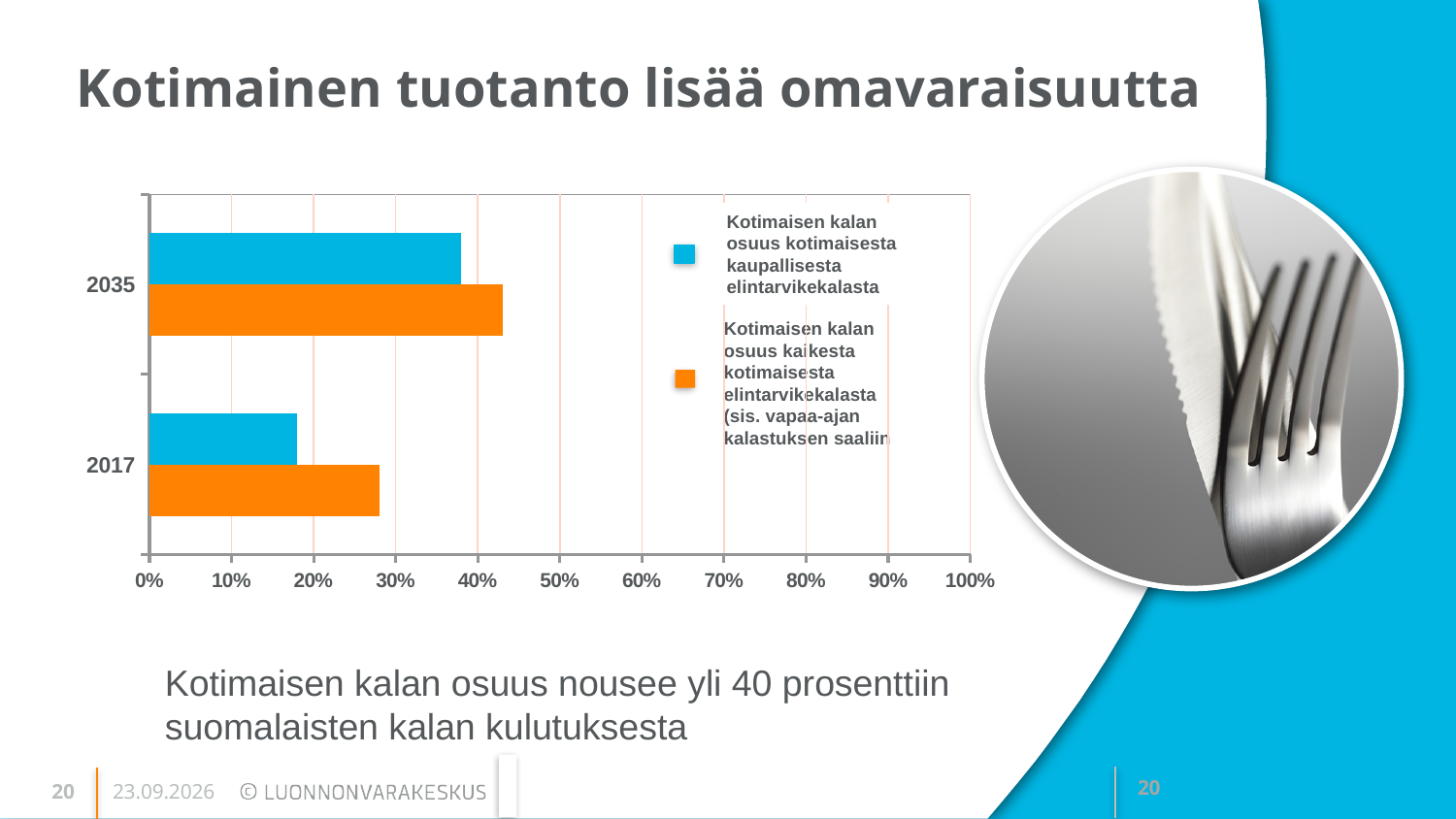
Is the 2035 value for 'Kotimaisen kalan osuus kotimaisesta kaupallisesta elintarvikekalasta' greater or less than 30%? greater Which year has the lower value for the series 'Kotimaisen kalan osuus kaikesta kotimaisesta elintarvikekalasta'? 2017 Do the values for both series rise or fall from 2017 to 2035? rise Which colour represents the series 'Kotimaisen kalan osuus kotimaisesta kaupallisesta elintarvikekalasta'? blue For the year 2017, which series has the larger value: the commercial food fish share (blue) or the share of all domestic food fish (orange)? share of all domestic food fish (orange) How many categories (years) are shown on the chart? 2 Which year has the higher value for the series 'Kotimaisen kalan osuus kotimaisesta kaupallisesta elintarvikekalasta'? 2035 How many series does the chart legend list? 2 What kind of chart is shown on the slide? bar chart Is the 2035 value for 'Kotimaisen kalan osuus kaikesta kotimaisesta elintarvikekalasta' greater or less than 40%? greater Is the 2017 value for 'Kotimaisen kalan osuus kaikesta kotimaisesta elintarvikekalasta' greater or less than 30%? less